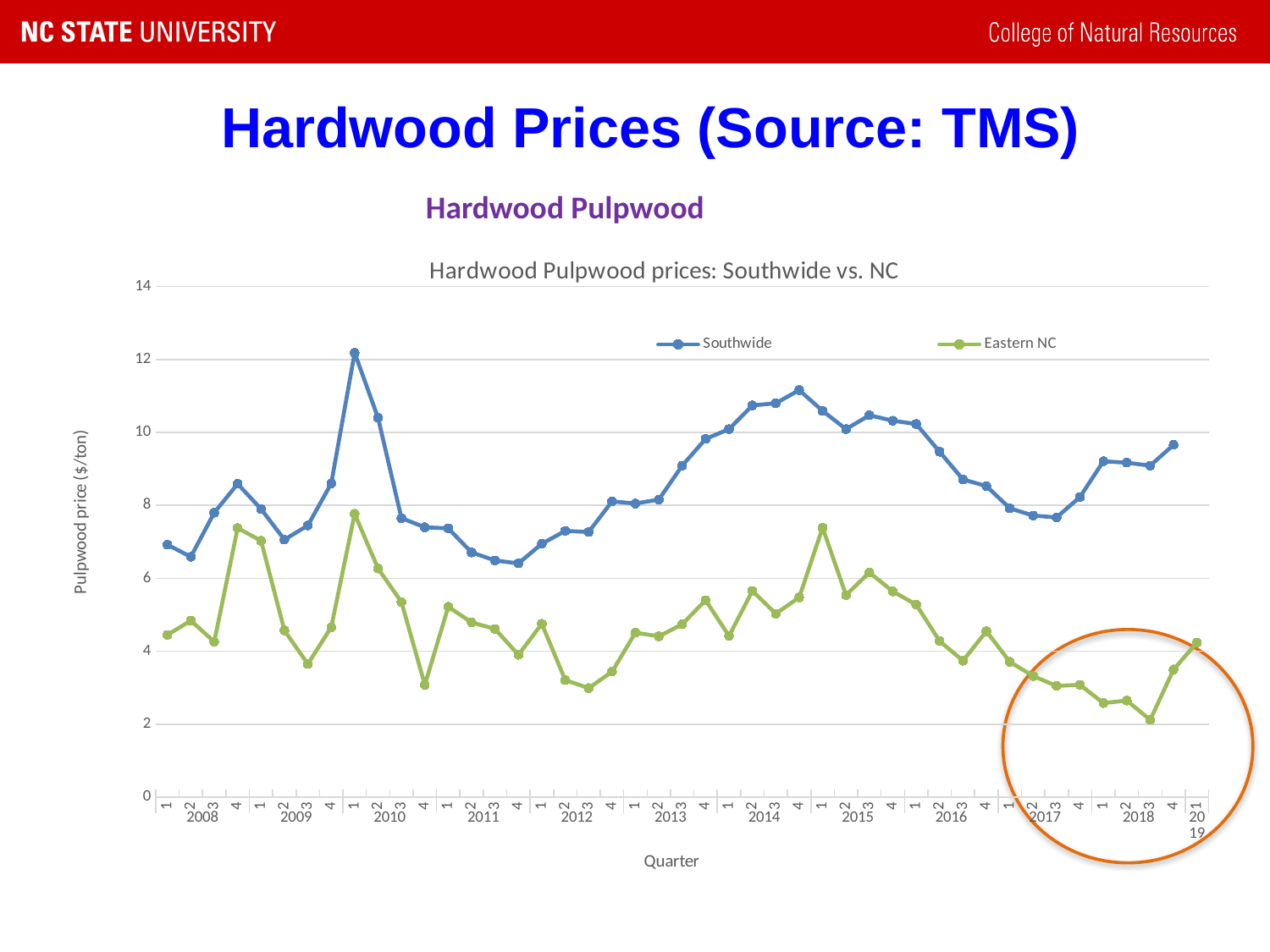
In which quarter does the Eastern NC series reach its lowest value? 2018 Q3 Does the Southwide series rise or fall from 2011 Q4 to 2014 Q4? Rise How many series does the legend list? 2 Is the Eastern NC value in 2015 Q1 greater or less than 6? greater What kind of chart is shown on the slide? Line chart What is the label of the vertical axis? Pulpwood price ($/ton) Which series has the higher value in 2010 Q1, Southwide or Eastern NC? Southwide Is the Eastern NC value in 2018 Q3 greater or less than 4? less Does the Eastern NC series rise or fall from 2017 Q1 to 2018 Q3? Fall What is the title of the chart? Hardwood Pulpwood prices: Southwide vs. NC Is the Southwide value in 2010 Q1 greater or less than 10? greater In which quarter does the Southwide series reach its highest value? 2010 Q1